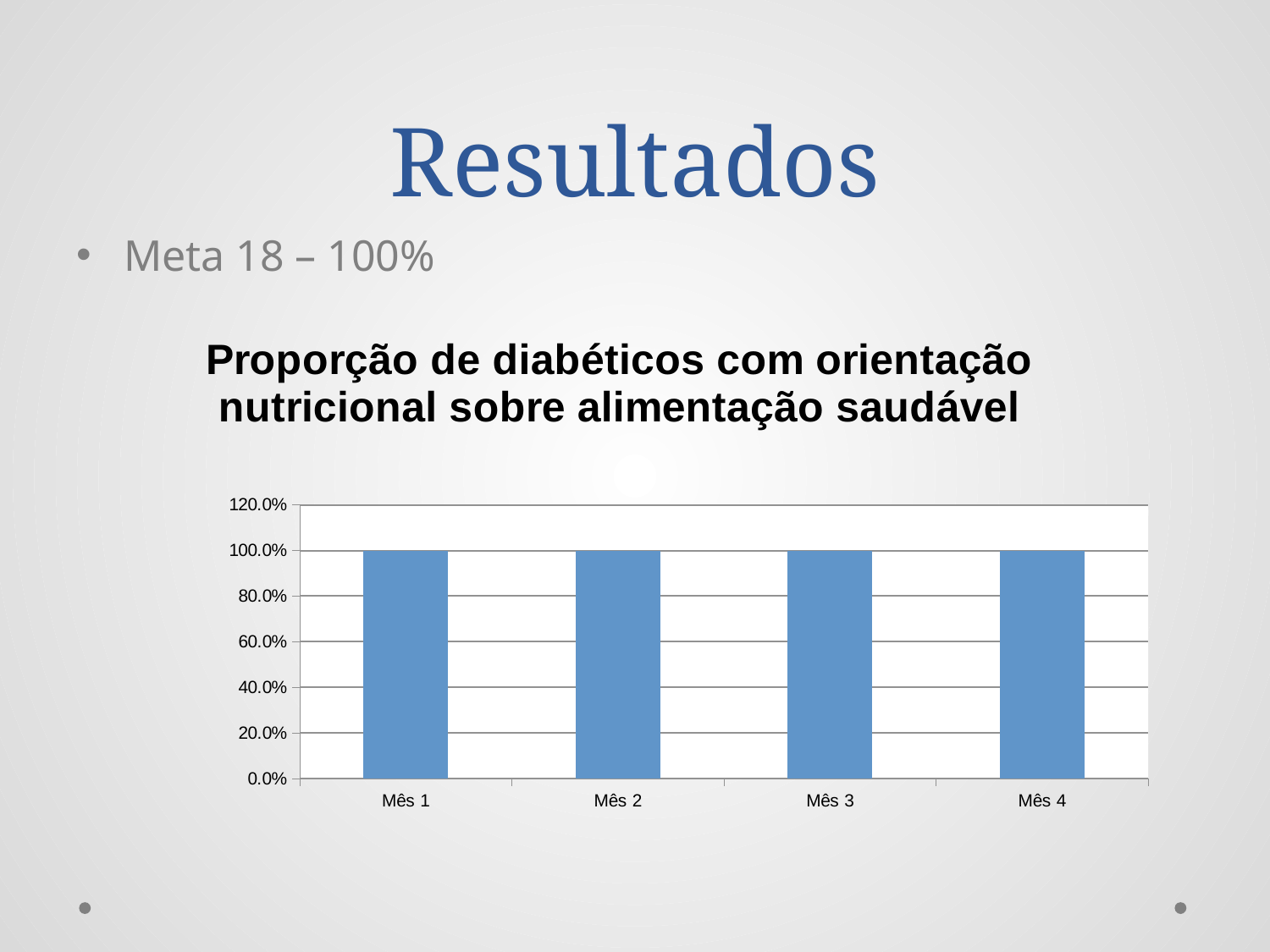
Is the value for Mês 2 greater or less than 80.0%? greater What is the value for Mês 1 in the chart? 100.0% What kind of chart is shown on the slide? bar chart What is the highest tick value shown on the y axis of the chart? 120.0% What is the value for Mês 3 in the chart? 100.0% How many categories (months) are shown on the x axis of the chart? 4 Do the values rise, fall, or stay the same from Mês 1 to Mês 4? stay the same What is the value for Mês 4 in the chart? 100.0% Is the value for Mês 4 greater or less than 120.0%? less What is the title of the chart? Proporção de diabéticos com orientação nutricional sobre alimentação saudável What is the difference between the values for Mês 1 and Mês 4? 0.0%